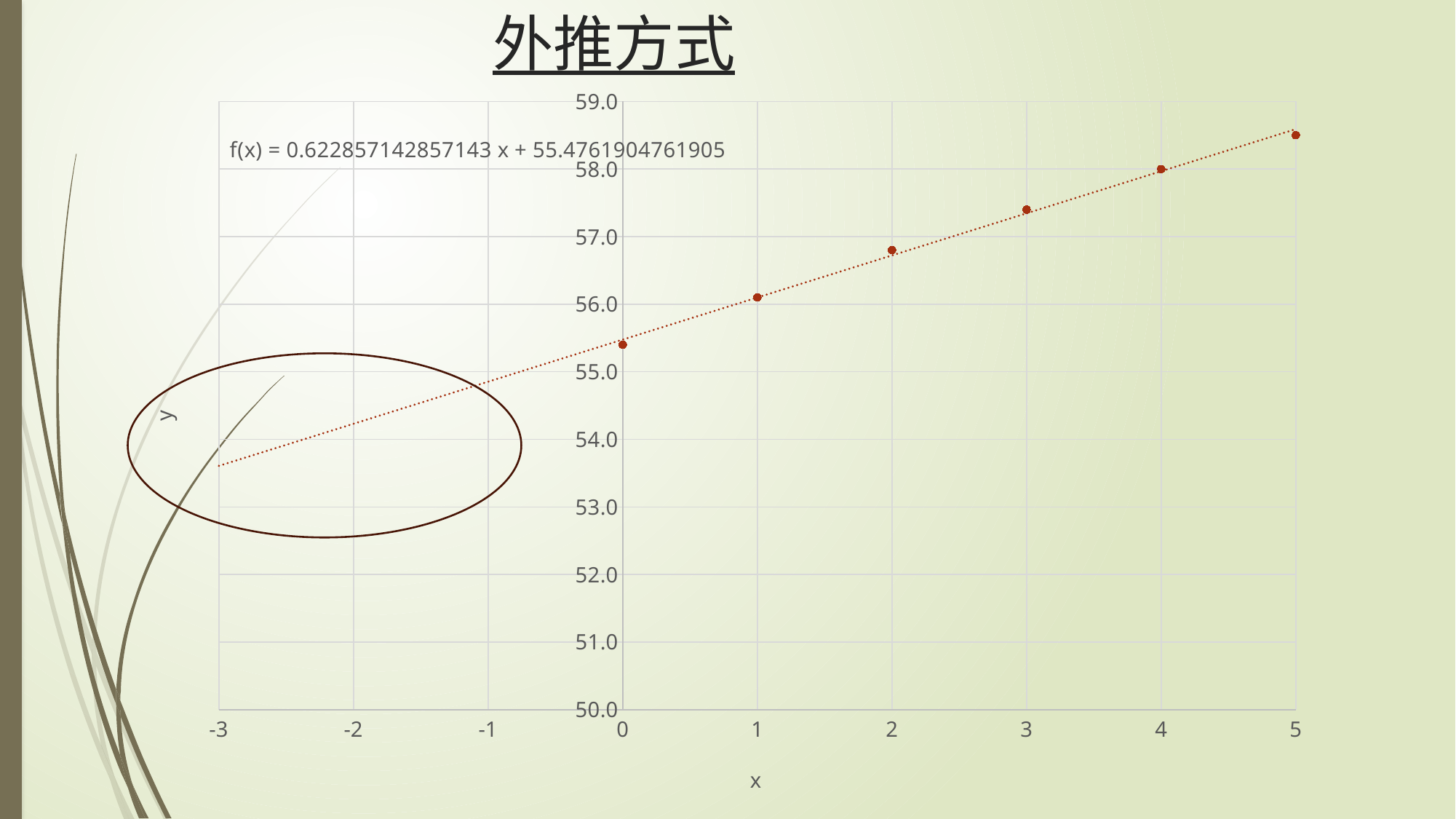
Which has the larger plotted y value, x = 3 or x = 1? x = 3 What kind of chart is shown on the slide? scatter chart At which x value is the plotted y value lowest? 0 What is the trendline equation printed on the chart? f(x) = 0.622857142857143 x + 55.4761904761905 How many data points are plotted on the chart? 6 Is the plotted value at x = 2 greater or less than 57.0? less What is the title of the slide above the chart? 外推方式 Do the plotted values rise or fall as x increases? rise Is the plotted value at x = 0 greater or less than 55.0? greater Is the plotted value at x = 5 greater or less than 58.0? greater At which x value is the plotted y value highest? 5